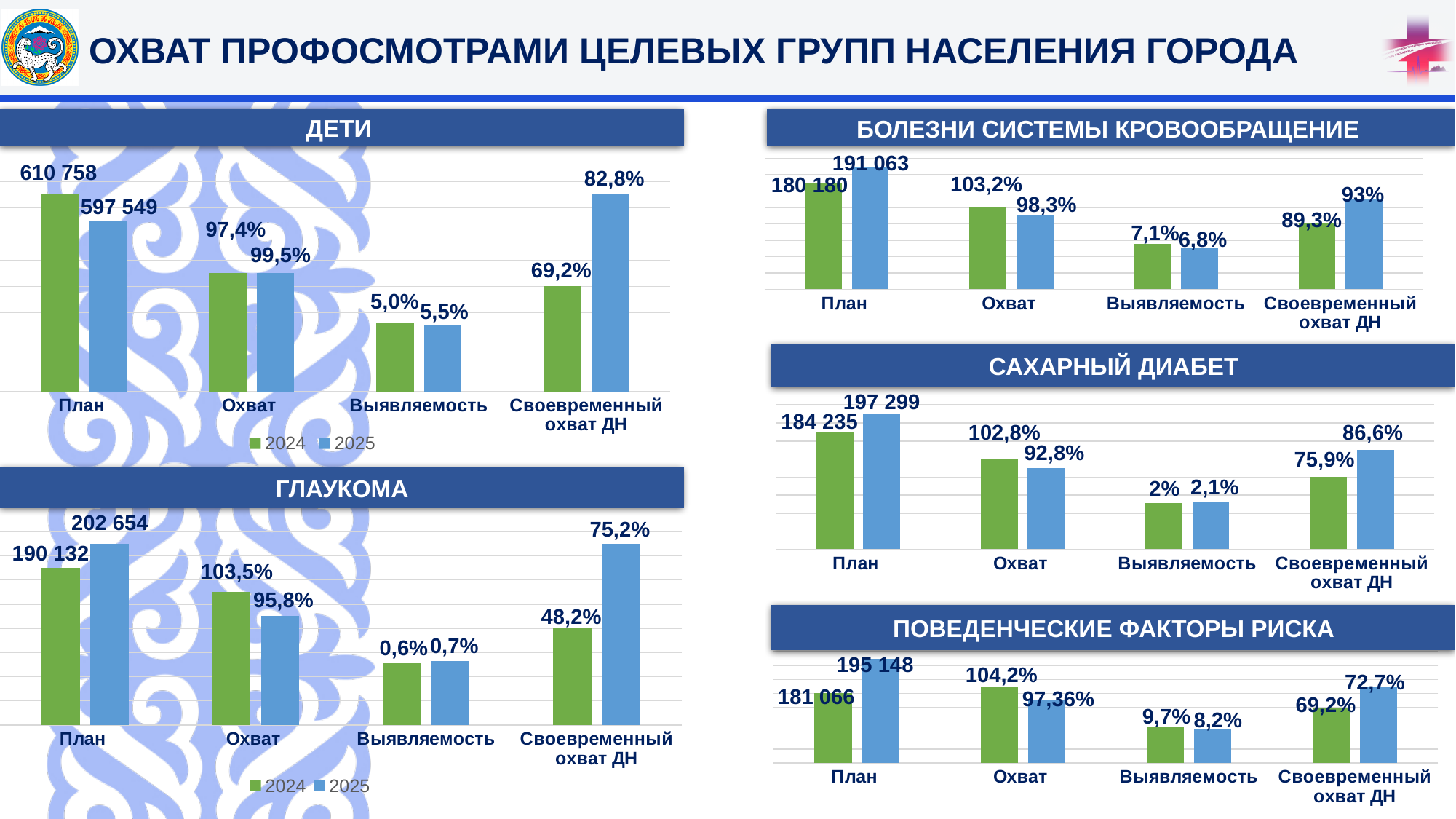
In the ГЛАУКОМА chart, what is the value for Охват in 2025? 95,8% In the САХАРНЫЙ ДИАБЕТ chart, what is the value for План in 2025? 197 299 How many series does the legend of the ГЛАУКОМА chart list? 2 In the БОЛЕЗНИ СИСТЕМЫ КРОВООБРАЩЕНИЕ chart, which is larger for Охват: the 2024 value or the 2025 value? 2024 In the ДЕТИ chart, what is the value for Своевременный охват ДН in 2025? 82,8% In the САХАРНЫЙ ДИАБЕТ chart, what is the difference between the 2025 and 2024 values for Своевременный охват ДН? 10,7% In the ГЛАУКОМА chart, what is the difference between the 2025 and 2024 values for Своевременный охват ДН? 27% How many categories are shown on the x axis of the ДЕТИ chart? 4 In the ПОВЕДЕНЧЕСКИЕ ФАКТОРЫ РИСКА chart, which is larger for Выявляемость: the 2024 value or the 2025 value? 2024 In the БОЛЕЗНИ СИСТЕМЫ КРОВООБРАЩЕНИЕ chart, what is the value for Выявляемость in 2024? 7,1% In the ПОВЕДЕНЧЕСКИЕ ФАКТОРЫ РИСКА chart, what is the value for Охват in 2025? 97,36% In the ДЕТИ chart, what is the value for План in 2024? 610 758